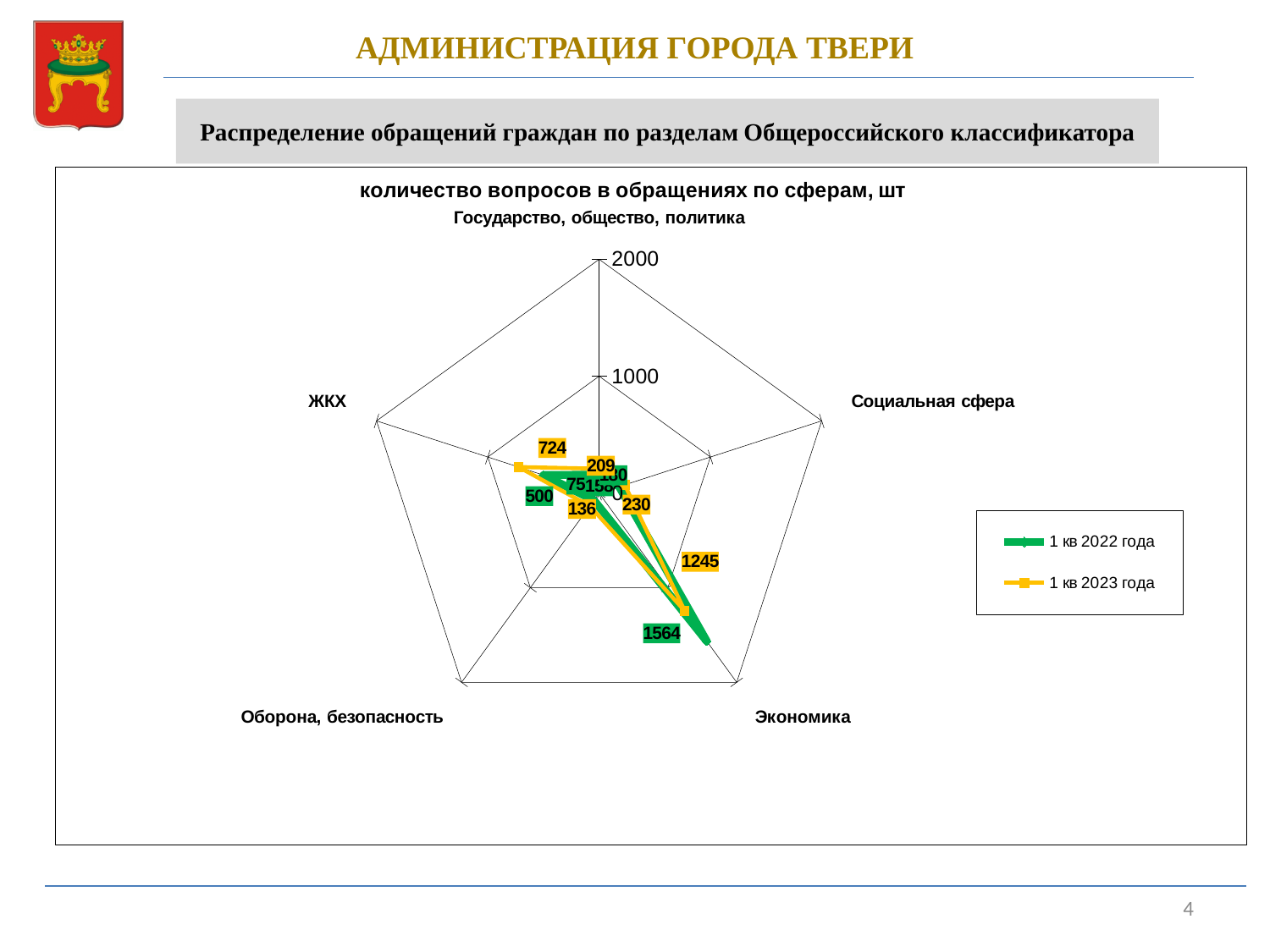
How many categories (axes) does the radar chart have? 5 What is the difference between the Экономика values for 1 кв 2022 года and 1 кв 2023 года? 319 How many series does the legend list? 2 For Экономика, which series has the larger value: 1 кв 2022 года or 1 кв 2023 года? 1 кв 2022 года What is the value for ЖКХ in the 1 кв 2023 года series? 724 What is the value for Экономика in the 1 кв 2023 года series? 1245 What is the value for ЖКХ in the 1 кв 2022 года series? 500 What kind of chart is shown on the slide? radar chart What is the title of the chart? количество вопросов в обращениях по сферам, шт What is the difference between the ЖКХ values for 1 кв 2023 года and 1 кв 2022 года? 224 Which category has the highest value in the 1 кв 2022 года series? Экономика What is the value for Экономика in the 1 кв 2022 года series? 1564